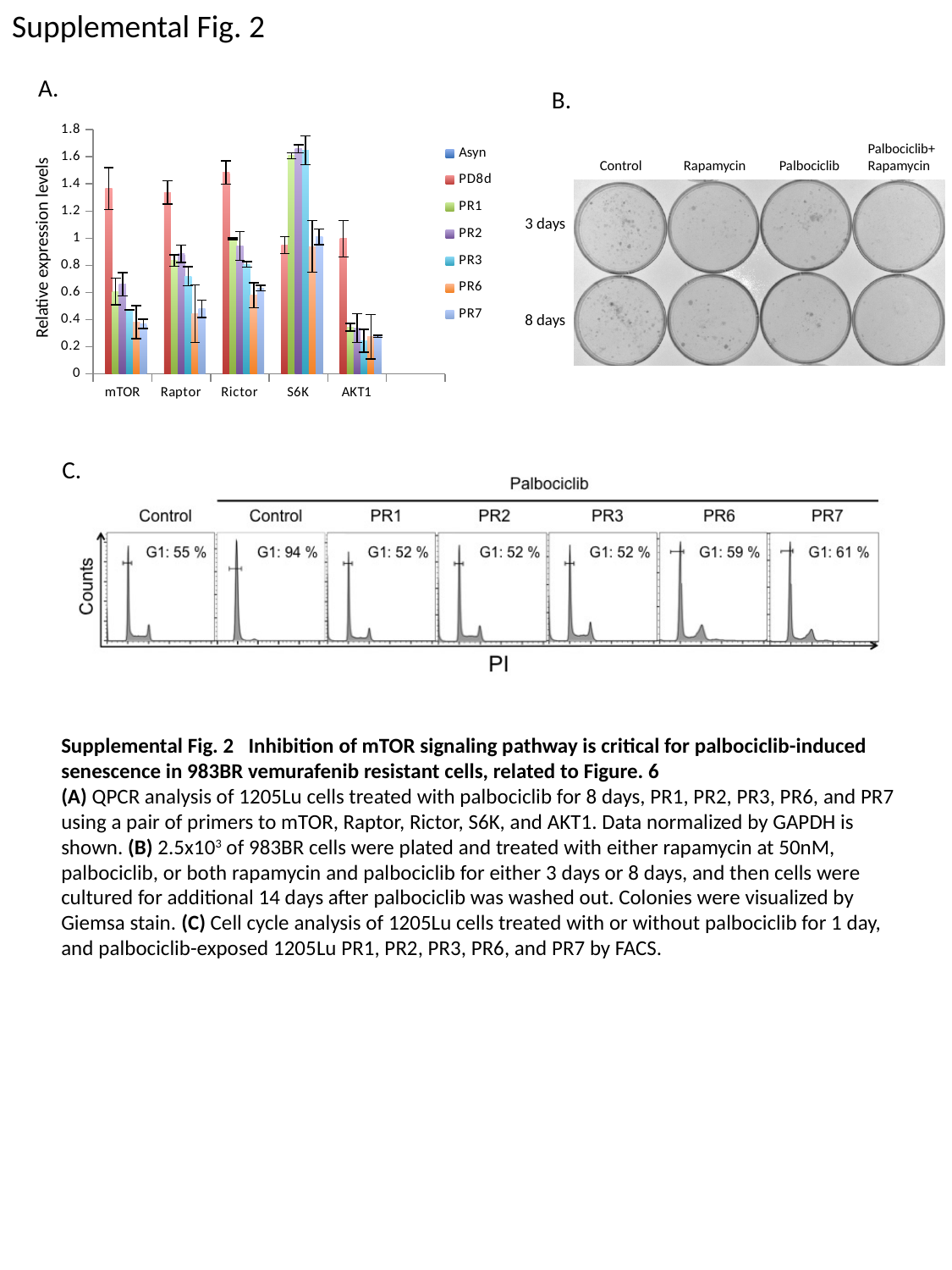
In the bar chart in panel A, how many categories are shown on the x axis? 5 In the bar chart in panel A, how many series does the legend list? 7 In the bar chart in panel A, is the PR2 value for S6K greater or less than 1.4? greater In the bar chart in panel A, for S6K, which is larger: the PD8d value or the PR1 value? PR1 In the bar chart in panel A, which category has the lowest PR6 value? AKT1 In the bar chart in panel A, what is the y-axis label? Relative expression levels In panel C, what is the G1 percentage shown for PR7? G1: 61 % What kind of chart is panel A? bar chart In the bar chart in panel A, which category has the highest PR2 value? S6K In the bar chart in panel A, is the PD8d value for mTOR greater or less than 1.2? greater In panel C, which sample has the highest G1 percentage? Palbociclib Control (94 %) In the bar chart in panel A, is the PR6 value for AKT1 greater or less than 0.2? greater